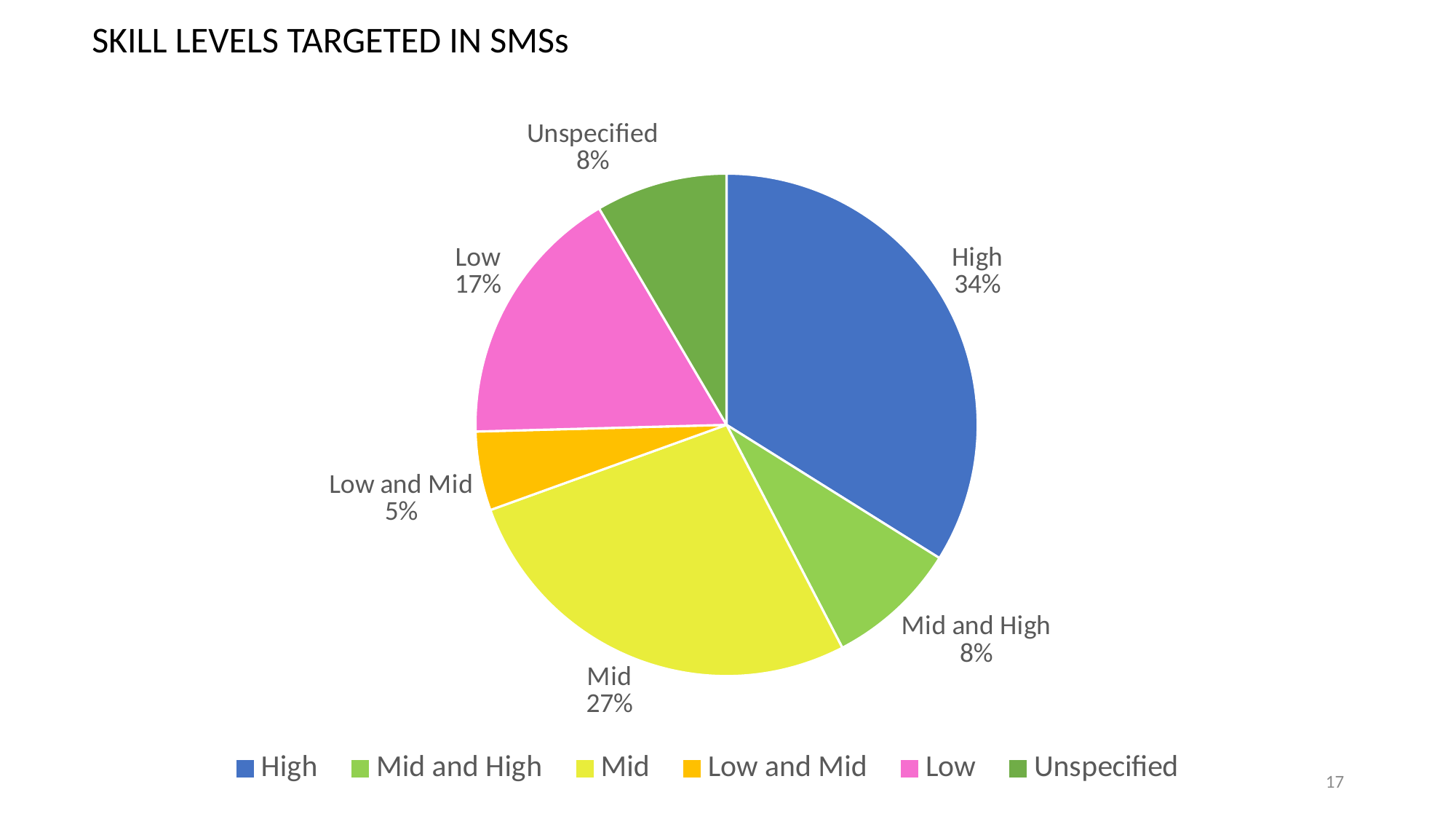
What type of chart is shown on the slide? Pie chart What percentage is shown for the Mid slice? 27% What is the difference in percentage points between Low and Unspecified? 9 What percentage is shown for Unspecified? 8% Which category has the largest share of the pie? High What percentage is shown for Low and Mid? 5% What is the difference in percentage points between High and Mid? 7 Which category has the smallest share of the pie? Low and Mid How many slices does the pie chart have? 6 Which is larger, the Low slice or the Mid and High slice? Low What share of the pie does the High slice represent? 34% What is the title of the chart? SKILL LEVELS TARGETED IN SMSs